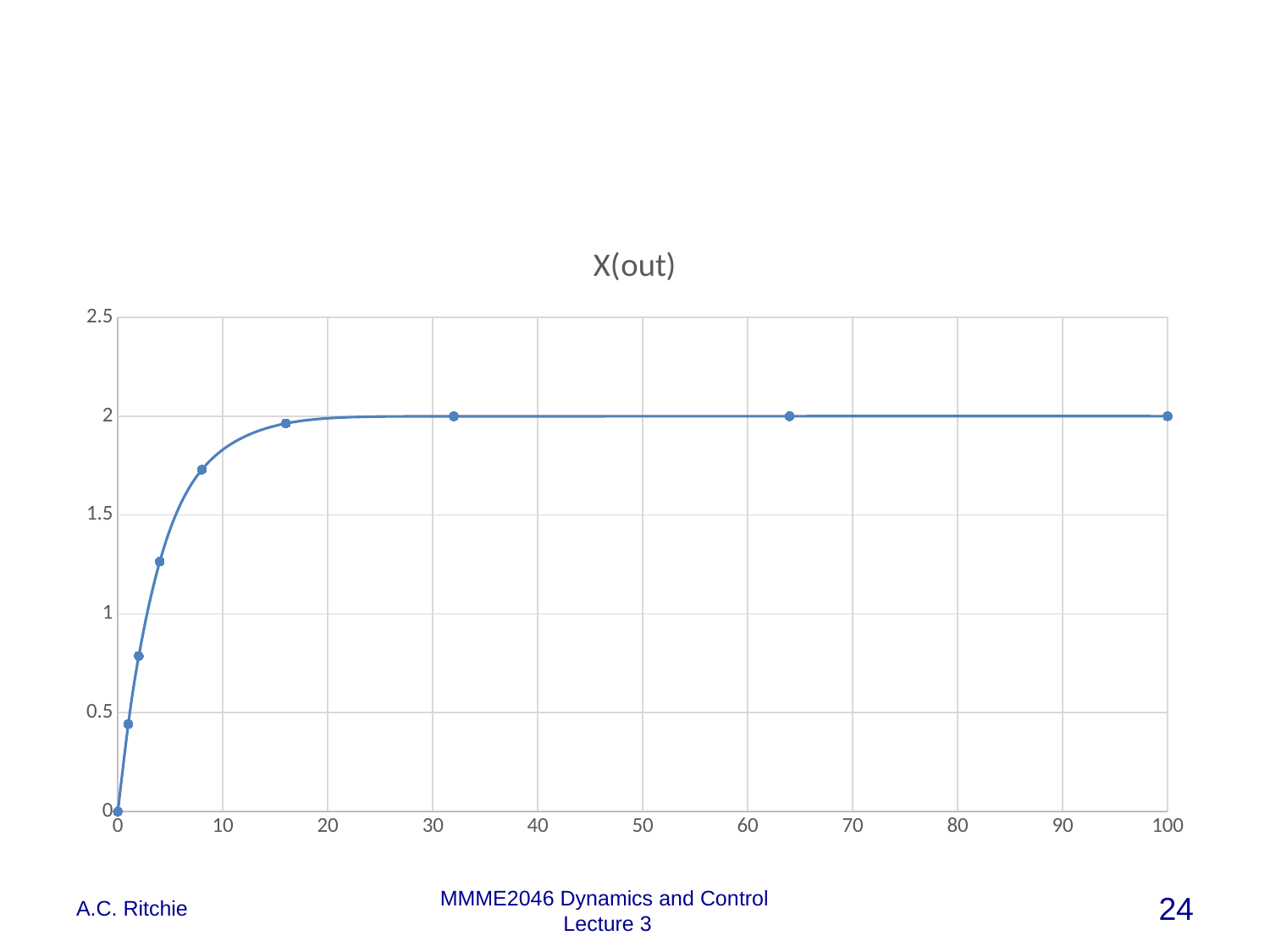
What is the title of the chart? X(out) Is the value of X(out) at x = 4 greater or less than 1? greater Which is larger, the value of X(out) at x = 8 or at x = 2? x = 8 At which x value is X(out) lowest? 0 Is the value of X(out) at x = 1 greater or less than 0.5? less Is the value of X(out) at x = 2 greater or less than 1? less How does X(out) change as x increases along the x axis? rises quickly then levels off at 2 How many data points are plotted on the chart? 9 What kind of chart is shown on the slide? line chart What is the highest tick value shown on the vertical axis? 2.5 What is the value of X(out) at x = 0? 0